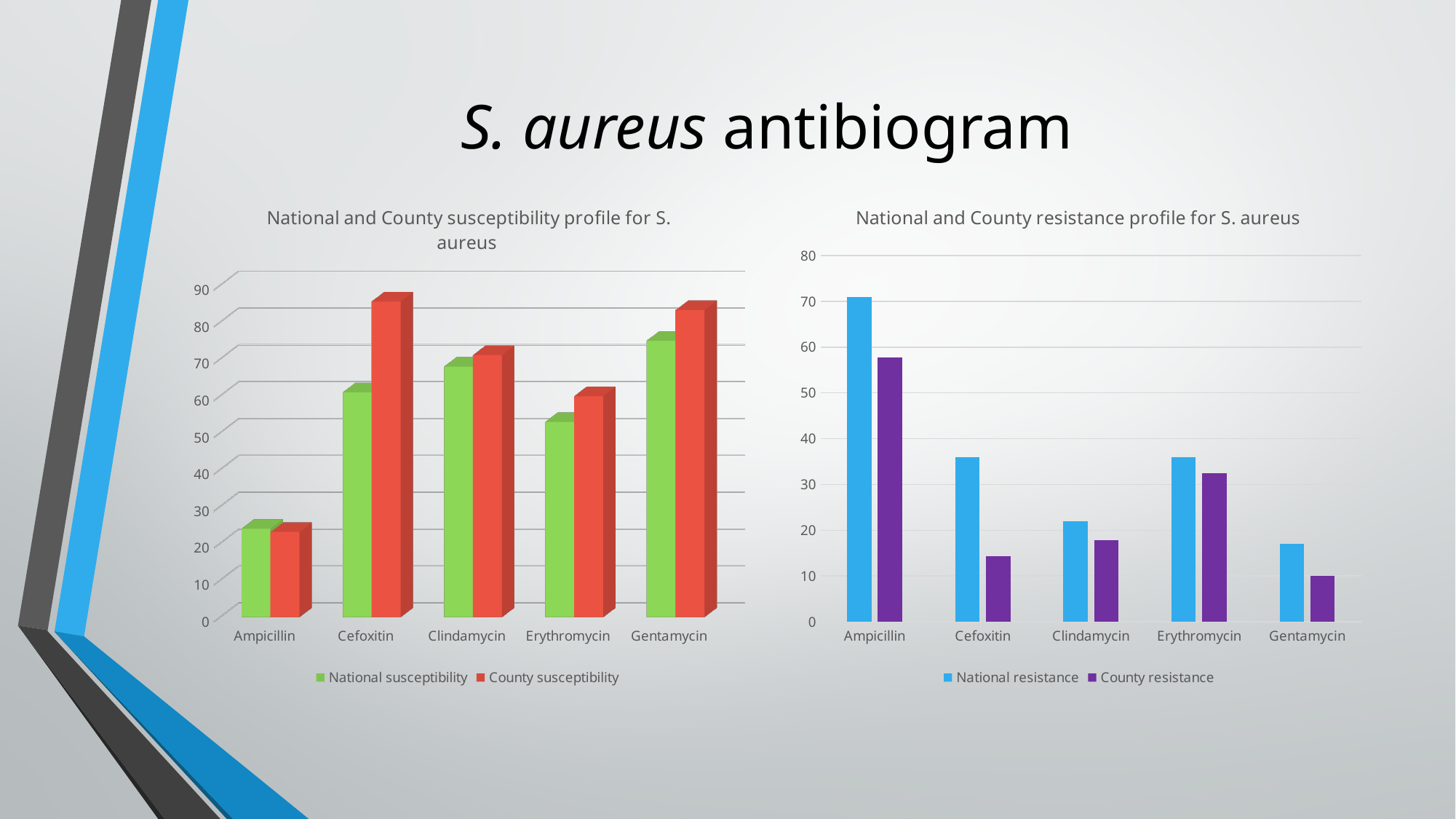
In the right chart, 'National and County resistance profile for S. aureus', which antibiotic has the lowest County resistance? Gentamycin How many antibiotics are shown on the x axis of the left chart, 'National and County susceptibility profile for S. aureus'? 5 In the left chart, 'National and County susceptibility profile for S. aureus', which antibiotic has the lowest National susceptibility? Ampicillin In the right chart, 'National and County resistance profile for S. aureus', is the County resistance for Cefoxitin greater or less than 20? less In the left chart, 'National and County susceptibility profile for S. aureus', which antibiotic has the highest County susceptibility? Cefoxitin In the left chart, 'National and County susceptibility profile for S. aureus', which is larger for Cefoxitin: National susceptibility or County susceptibility? County susceptibility How many series does the legend of the left chart, 'National and County susceptibility profile for S. aureus', list? 2 What kind of chart is the 'National and County susceptibility profile for S. aureus' chart on the left? bar chart In the right chart, 'National and County resistance profile for S. aureus', is the National resistance for Ampicillin greater or less than 60? greater In the right chart, 'National and County resistance profile for S. aureus', which antibiotic has the highest National resistance? Ampicillin What are the two legend entries of the right chart, 'National and County resistance profile for S. aureus'? National resistance and County resistance In the left chart, 'National and County susceptibility profile for S. aureus', is the County susceptibility for Cefoxitin greater or less than 80? greater